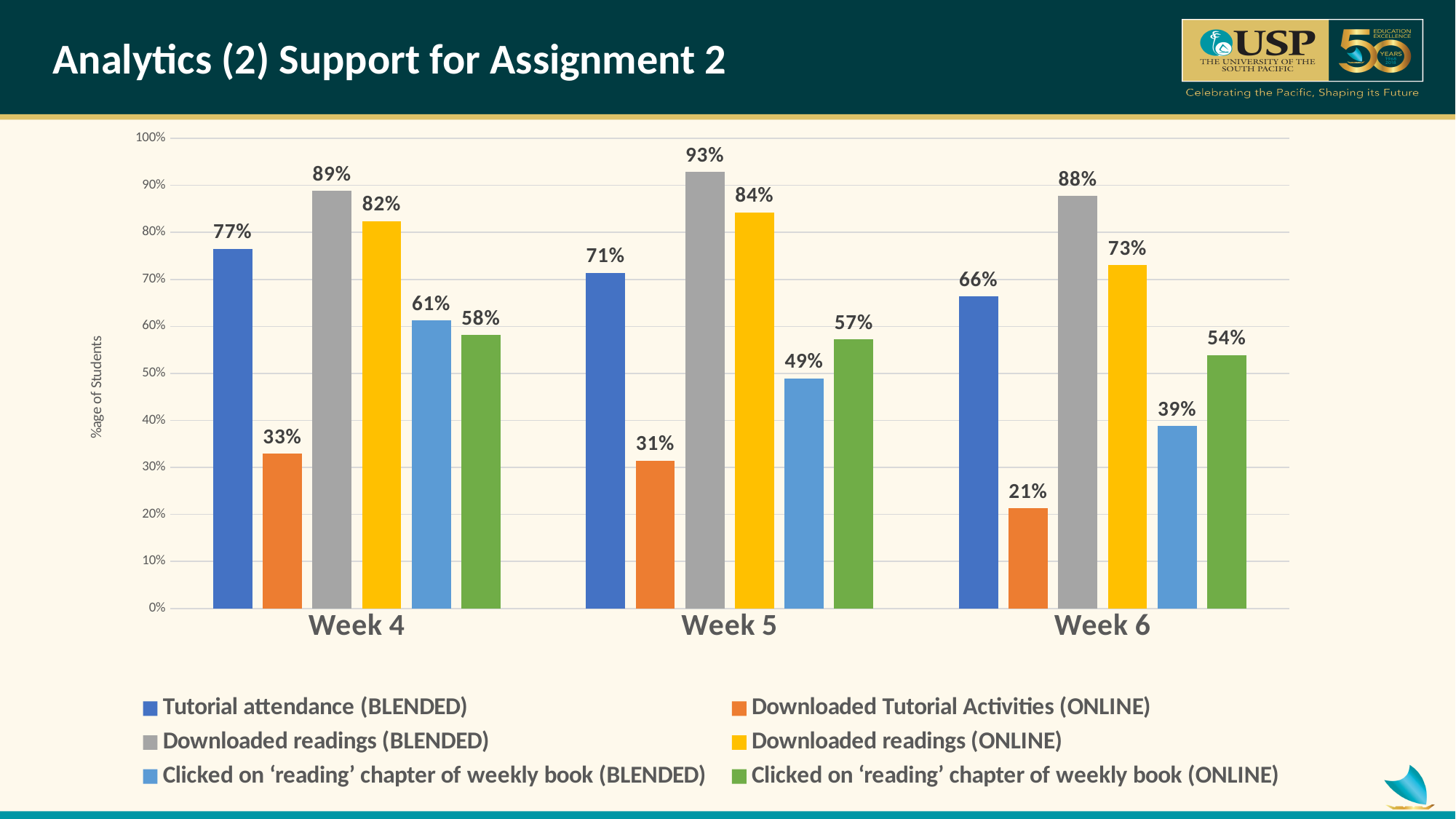
Which series has the lowest value in Week 6? Downloaded Tutorial Activities (ONLINE) What is the label of the y axis? %age of Students What is the value for Downloaded readings (ONLINE) in Week 6? 73% Which week has the highest value for Downloaded readings (BLENDED)? Week 5 How many weeks are shown on the x axis? 3 What is the value for Downloaded Tutorial Activities (ONLINE) in Week 5? 31% What is the value for Tutorial attendance (BLENDED) in Week 4? 77% What kind of chart is shown on the slide? Bar chart Which is larger in Week 5: Clicked on 'reading' chapter of weekly book (BLENDED) or Clicked on 'reading' chapter of weekly book (ONLINE)? Clicked on 'reading' chapter of weekly book (ONLINE) What is the difference between Downloaded readings (BLENDED) and Downloaded readings (ONLINE) in Week 6? 15% How many series does the legend list? 6 Does Tutorial attendance (BLENDED) rise or fall from Week 4 to Week 6? Fall